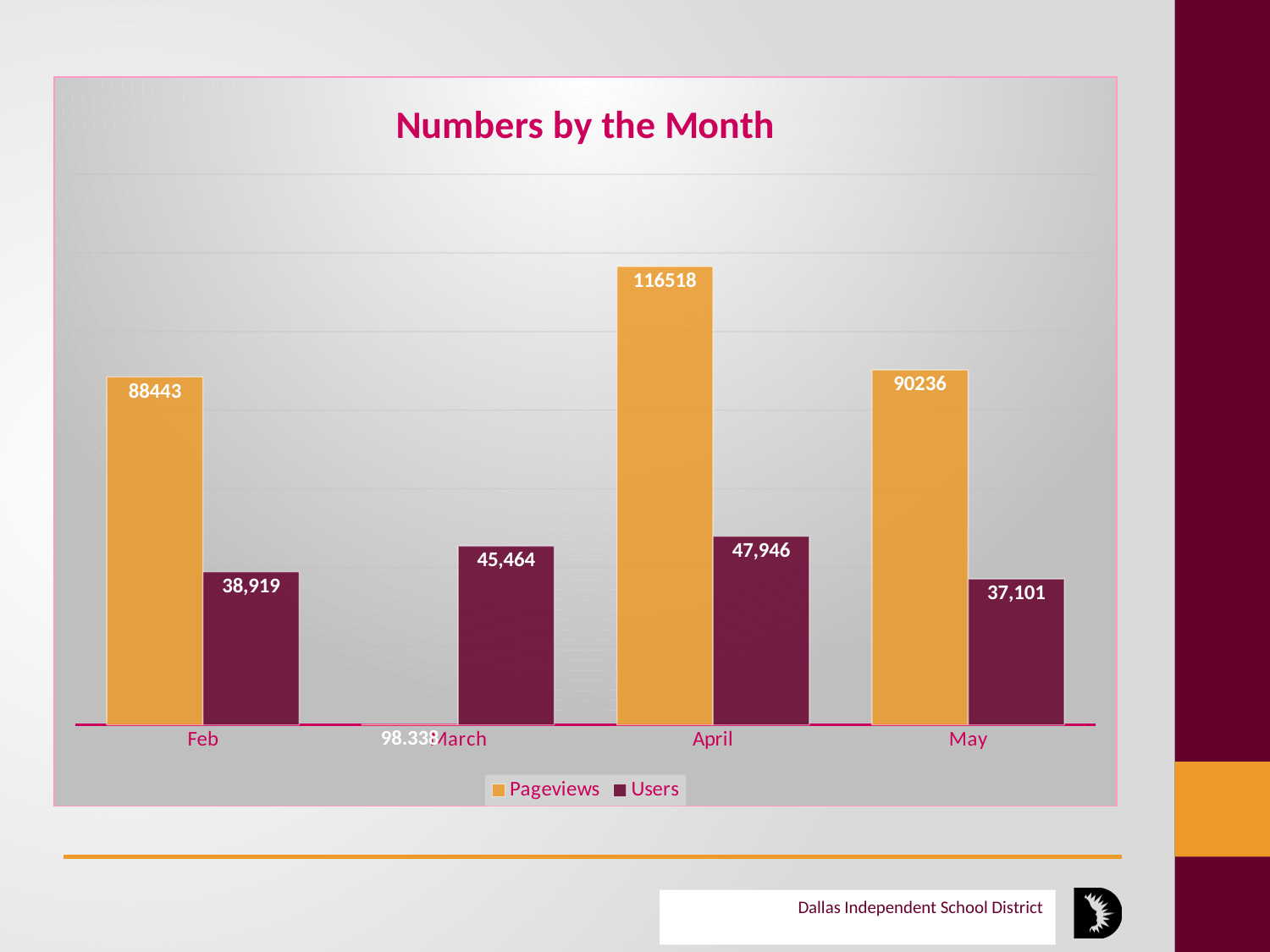
Which is larger, the Pageviews value for May or the Pageviews value for Feb? May What is the Users value for March? 45,464 Which month has the lowest Users value? May What is the Pageviews value for April? 116518 How many series does the legend list? 2 What is the Pageviews value for Feb? 88443 How many months are shown on the x axis? 4 What is the Users value for May? 37,101 What type of chart is shown on the slide? bar chart What is the title of the chart? Numbers by the Month What is the difference between the Users values for April and Feb? 9,027 Which month has the highest Pageviews value? April